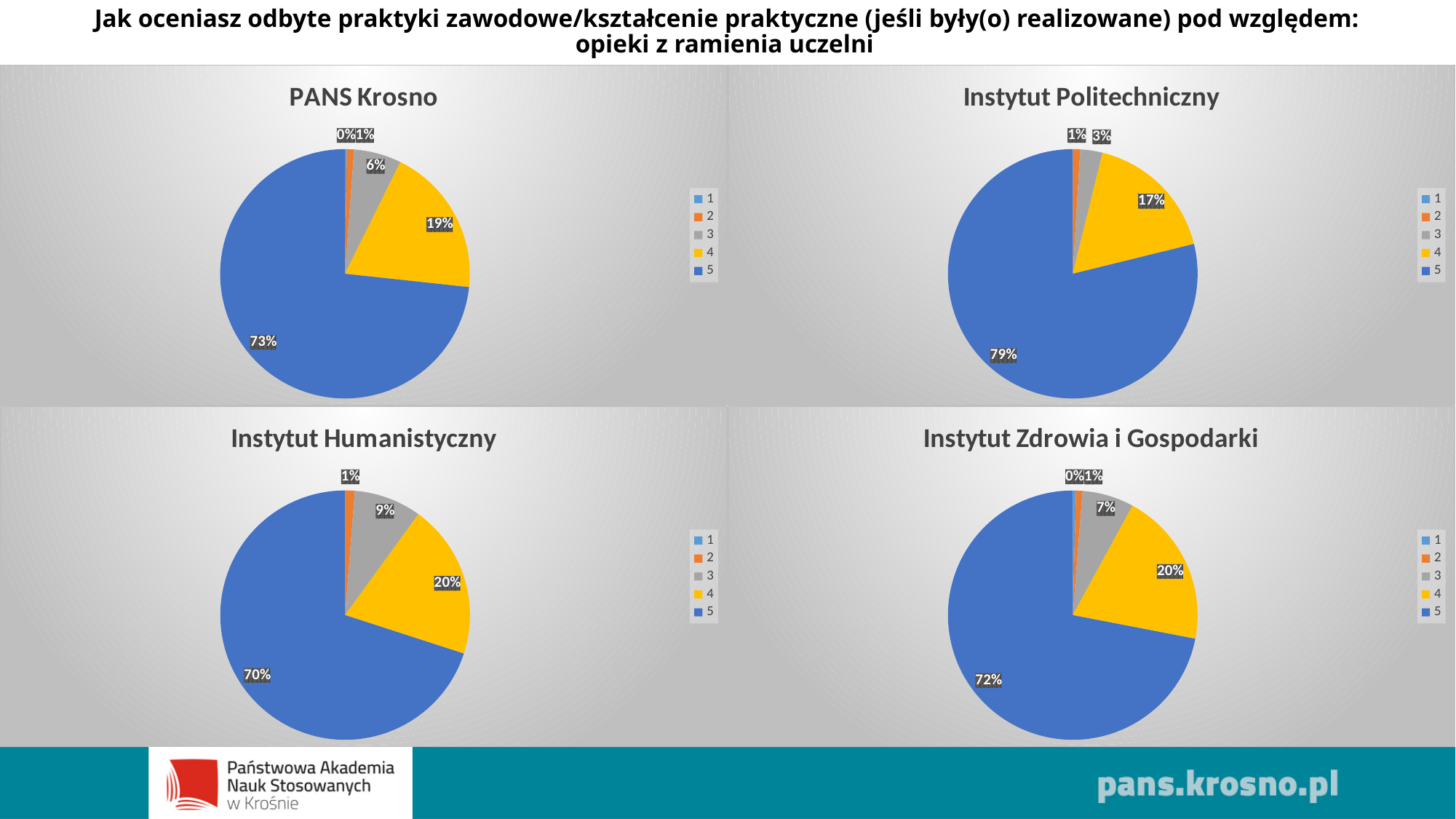
In the PANS Krosno pie chart, what share does category 5 have? 73% In the Instytut Politechniczny pie chart, what share does category 5 have? 79% In the PANS Krosno pie chart, what is the difference between the shares of category 5 and category 4? 54% In the Instytut Humanistyczny pie chart, which category has the largest slice? 5 Which is larger: the share of category 5 in the Instytut Politechniczny chart or in the Instytut Humanistyczny chart? Instytut Politechniczny In the Instytut Politechniczny pie chart, what share does category 4 have? 17% How many series does the legend of the PANS Krosno chart list? 5 In the Instytut Zdrowia i Gospodarki pie chart, what share does category 4 have? 20% In the Instytut Humanistyczny pie chart, what share does category 3 have? 9% What type of chart is used for Instytut Zdrowia i Gospodarki? Pie chart In the PANS Krosno pie chart, what share does category 4 have? 19% In the Instytut Zdrowia i Gospodarki pie chart, which category has the smallest slice? 1